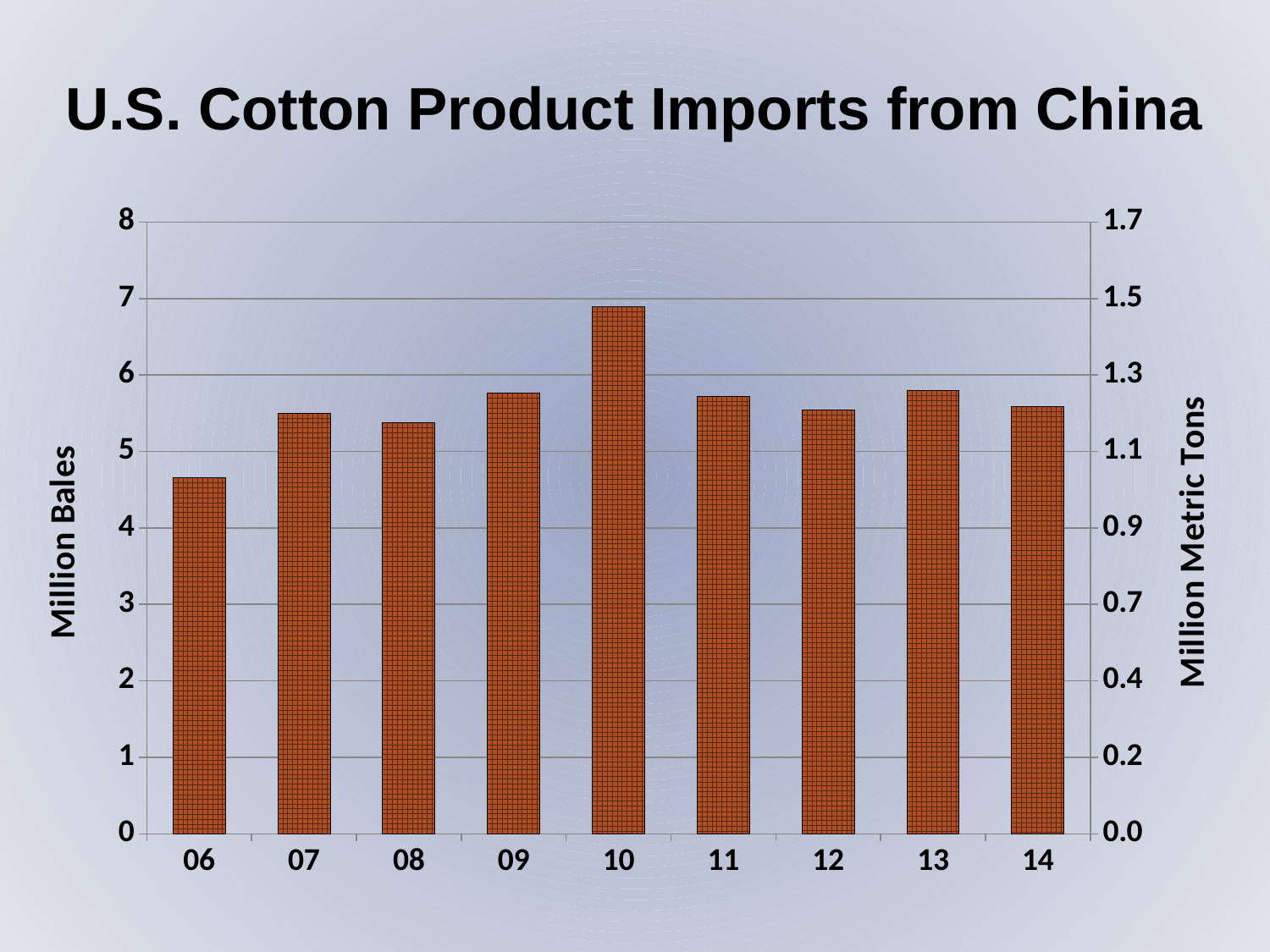
What is the title of the chart? U.S. Cotton Product Imports from China Is the value for 06 greater or less than 5 million bales? less What is the label on the left vertical axis? Million Bales How many years (bars) are plotted on the chart? 9 What kind of chart is shown on the slide? bar chart Which year has the highest value for U.S. cotton product imports from China? 10 Which year has the lowest value for U.S. cotton product imports from China? 06 Which year has the larger value, 06 or 07? 07 Is the value for 09 greater or less than 6 million bales? less Is the value for 07 greater or less than 5 million bales? greater Which year has the larger value, 10 or 13? 10